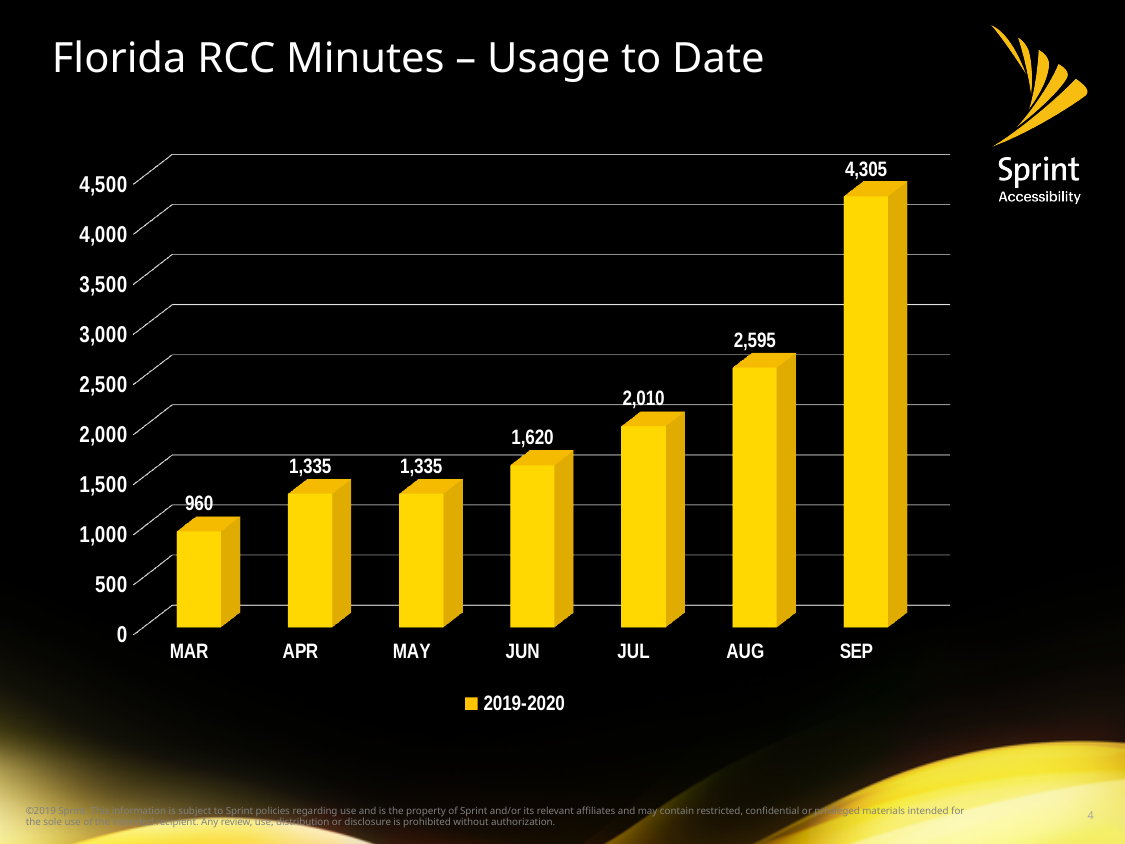
What is the difference between the values for JUN and MAR? 660 Which month has the lowest value? MAR What is the title of the chart? Florida RCC Minutes – Usage to Date What is the value for MAR? 960 What is the difference between the values for SEP and AUG? 1,710 How many series does the legend list? 1 Which is larger, the value for AUG or the value for JUL? AUG What kind of chart is shown? bar chart Which month has the highest value? SEP How many months are shown on the x axis? 7 What is the value for JUL? 2,010 What is the value for SEP? 4,305